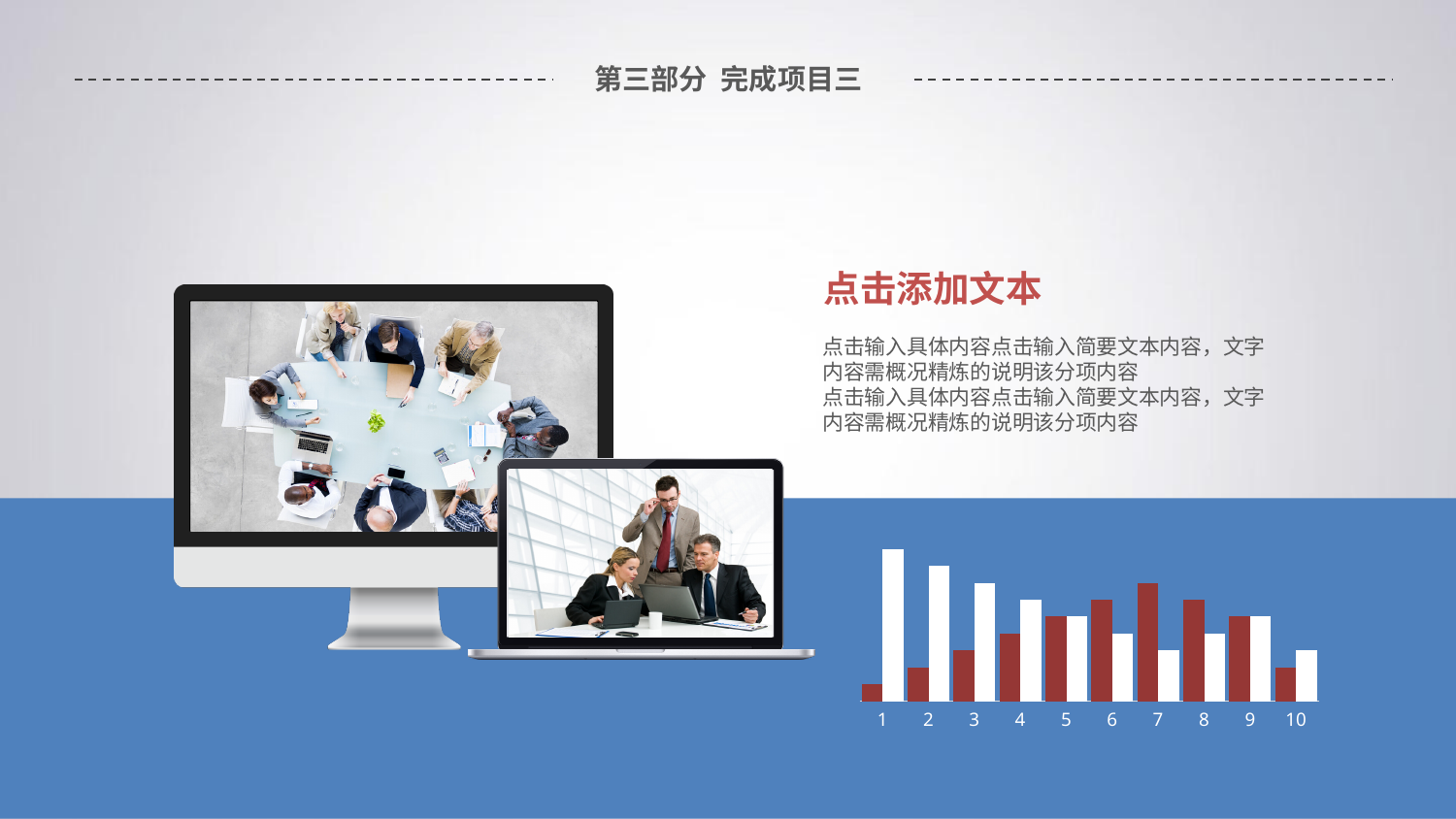
Do the white bars rise or fall from category 1 to category 10? fall How many bars are plotted for each category in the bar chart? 2 Which category has the tallest red bar? 7 What kind of chart is shown at the bottom right of the slide? bar chart At category 1, which bar is taller, the red one or the white one? white How many categories are shown on the x axis of the bar chart? 10 Which category has the shortest red bar? 1 At category 7, which bar is taller, the red one or the white one? red What are the labels on the x axis of the bar chart? 1 to 10 What two colours are the bars in the chart? red and white Which category has the tallest white bar? 1